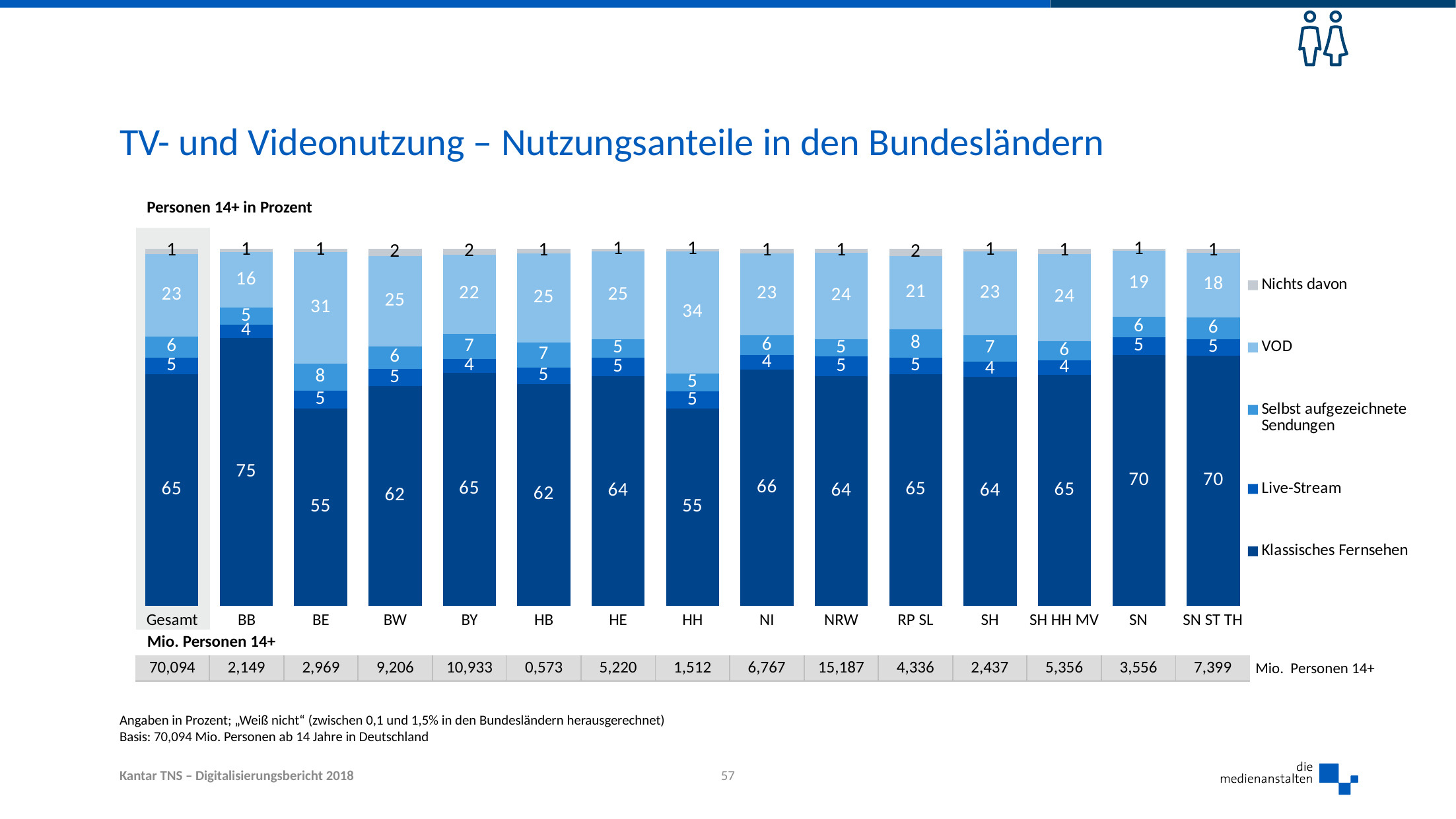
What is the difference between the VOD values for HH and BB? 18 What is the Mio. Personen 14+ figure shown for NRW? 15,187 What kind of chart is shown on the slide? stacked bar chart What is the Selbst aufgezeichnete Sendungen value for BE? 8 Which category has the lowest VOD value? BB How many bars (categories) are plotted in the chart? 15 How many series does the legend list? 5 Which category has the highest Klassisches Fernsehen value? BB Which has a larger Klassisches Fernsehen value, SN or BW? SN What is the VOD value for HH? 34 Which legend entry is shown in the lightest grey colour? Nichts davon What is the Klassisches Fernsehen value for BB? 75